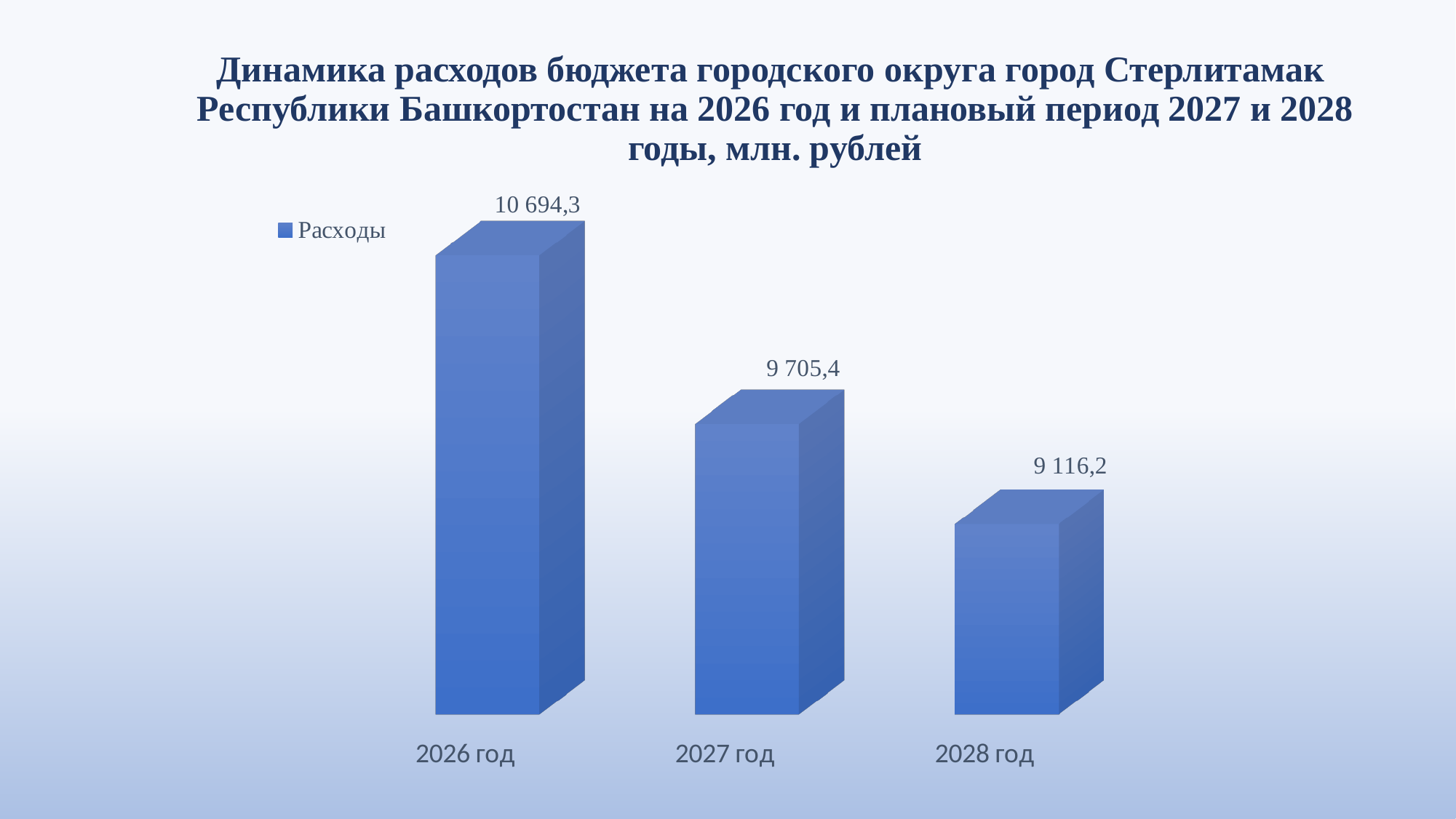
What kind of chart is shown on the slide? Bar chart What is the difference between the values for 2026 год and 2027 год? 988,9 Do the values rise or fall from 2026 год to 2028 год? Fall How many years (categories) are shown on the chart? 3 What is the difference between the values for 2026 год and 2028 год? 1 578,1 What is the value for 2027 год? 9 705,4 Which year has the lowest expenditure value? 2028 год What is the value for 2026 год? 10 694,3 Which is larger, the value for 2027 год or the value for 2028 год? 2027 год Which year has the highest expenditure value? 2026 год What is the difference between the values for 2027 год and 2028 год? 589,2 What is the value for 2028 год? 9 116,2